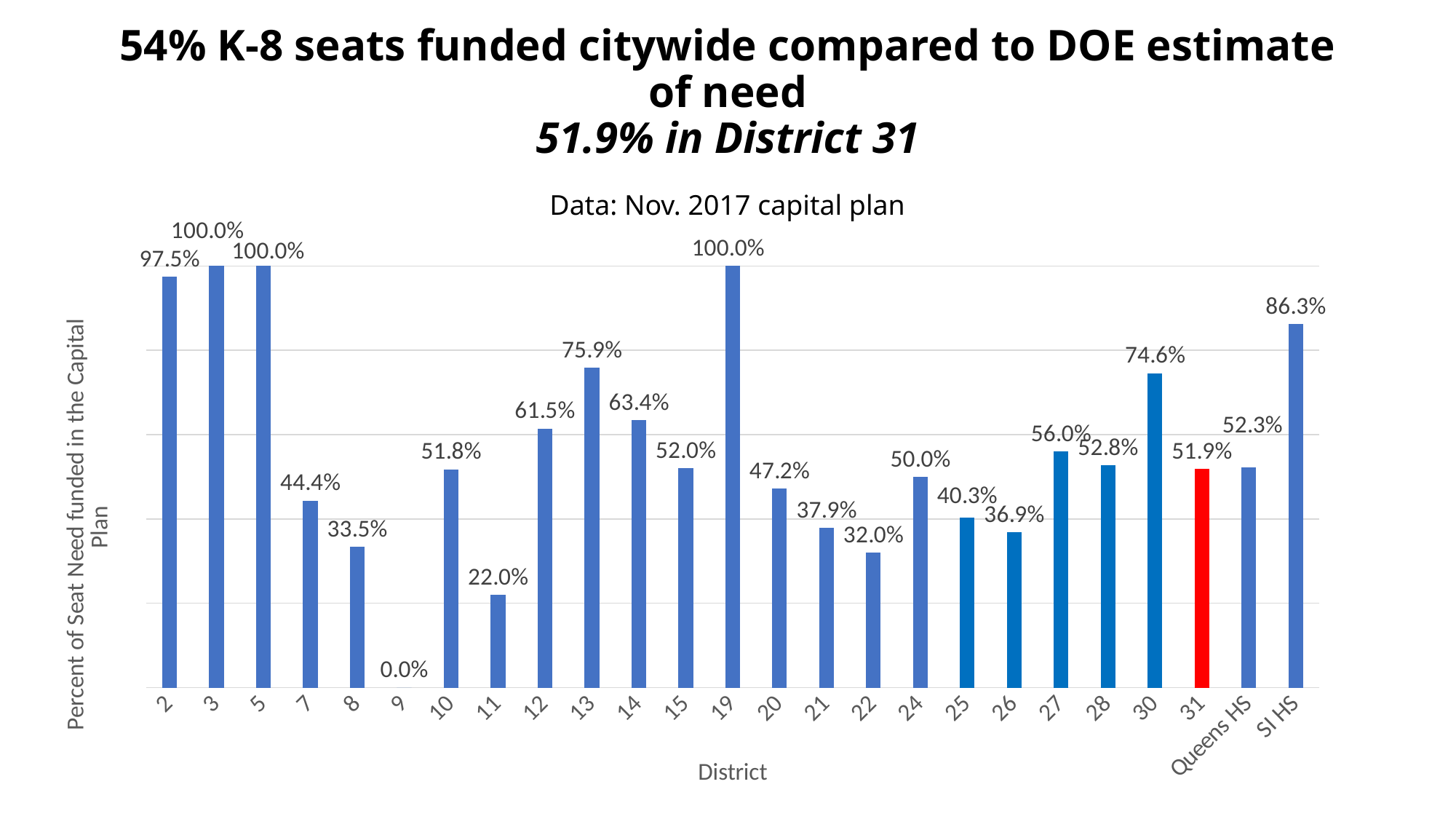
Which has a larger value, District 8 or District 22? District 8 What is the difference between the values for District 30 and District 31? 22.7% How many categories are shown on the x axis? 25 What is the difference between the values for District 2 and District 7? 53.1% What is the value for District 11? 22.0% What is the value for SI HS? 86.3% Which bar is coloured red? 31 Which district has the lowest percent of seat need funded? 9 What is the value for District 31? 51.9% What is the value for District 13? 75.9% What kind of chart is shown on the slide? Bar chart Which has a larger value, District 12 or District 14? District 14